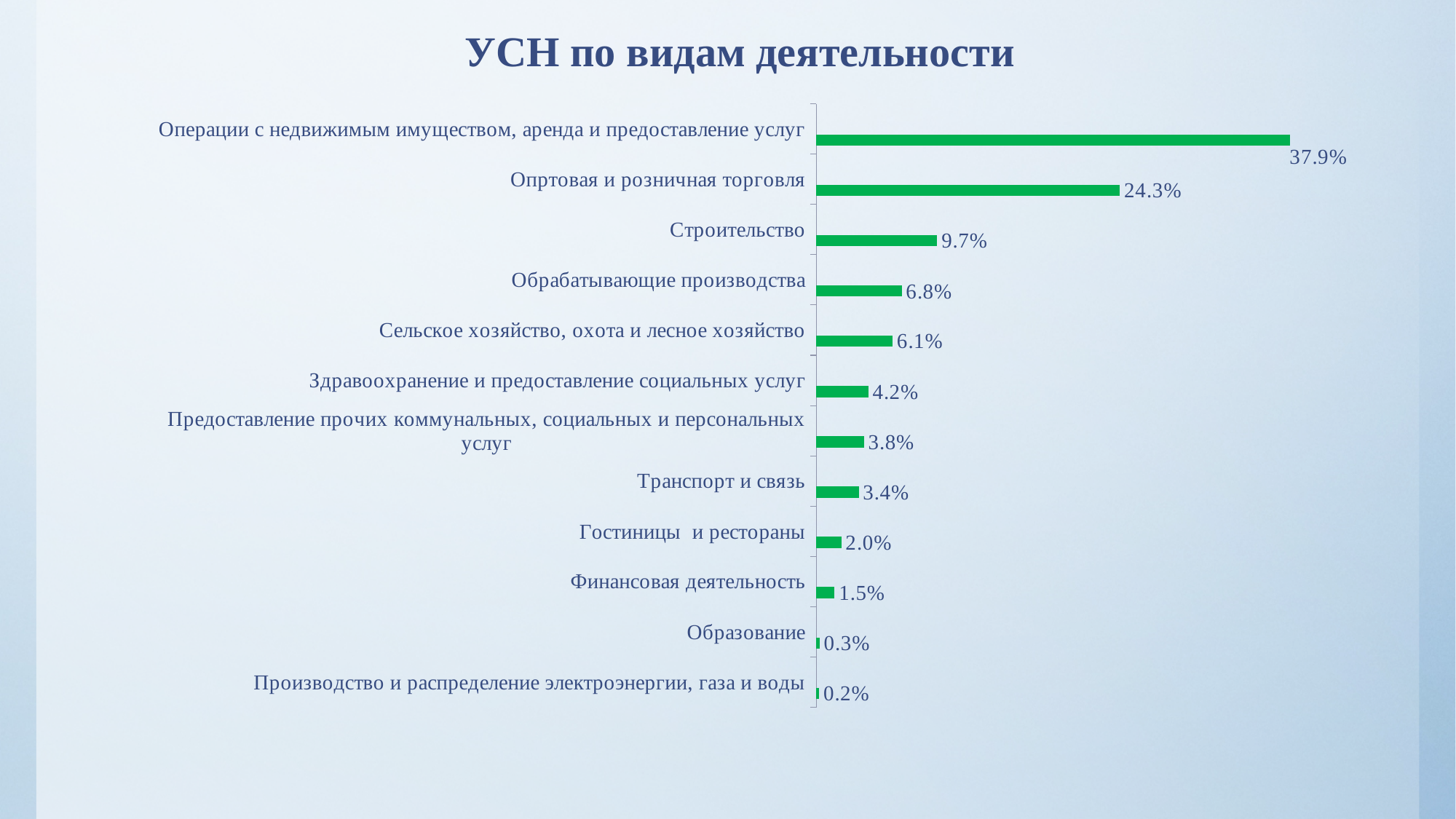
Which is larger: the value for Здравоохранение и предоставление социальных услуг or the value for Финансовая деятельность? Здравоохранение и предоставление социальных услуг How many categories are shown in the chart? 12 What colour are the bars in the chart? Green What is the value for Строительство? 9.7% What kind of chart is shown on the slide? Bar chart What is the difference between the values for Обрабатывающие производства and Сельское хозяйство, охота и лесное хозяйство? 0.7% What is the value for Гостиницы и рестораны? 2.0% Which category has the highest value? Операции с недвижимым имуществом, аренда и предоставление услуг Which category has the lowest value? Производство и распределение электроэнергии, газа и воды What is the difference between the values for Операции с недвижимым имуществом, аренда и предоставление услуг and Оптовая и розничная торговля? 13.6% What is the title of the chart? УСН по видам деятельности What is the value for Транспорт и связь? 3.4%